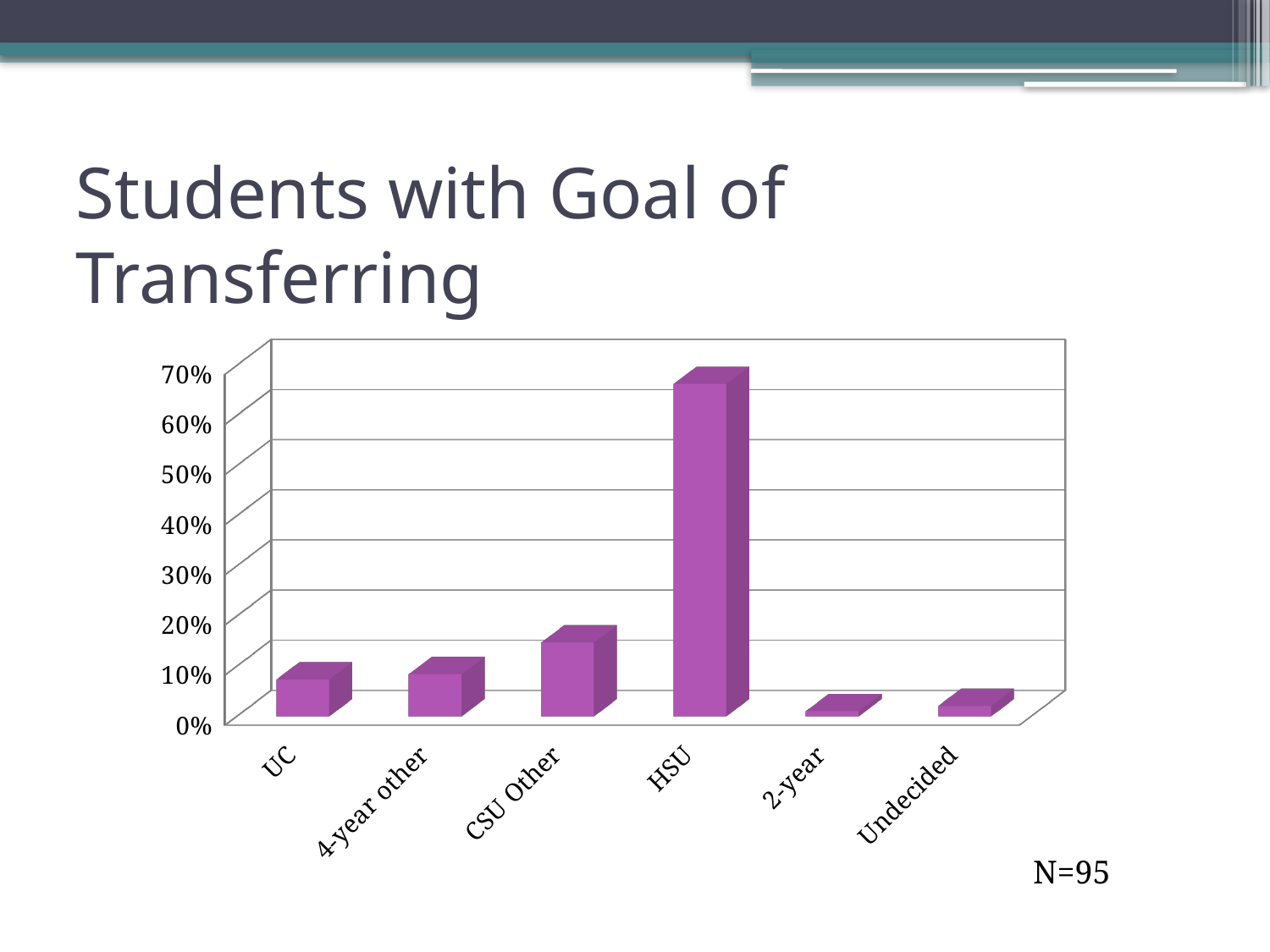
What kind of chart is shown on the slide? bar chart Is the value for 2-year greater or less than 10%? less Is the value for CSU Other greater or less than 10%? greater How many categories are shown on the x axis of the chart? 6 Is the value for HSU greater or less than 60%? greater Which is larger, the value for CSU Other or the value for UC? CSU Other Which category has the highest value in the chart? HSU What is the title of the slide containing the chart? Students with Goal of Transferring Which is larger, the value for HSU or the value for 4-year other? HSU